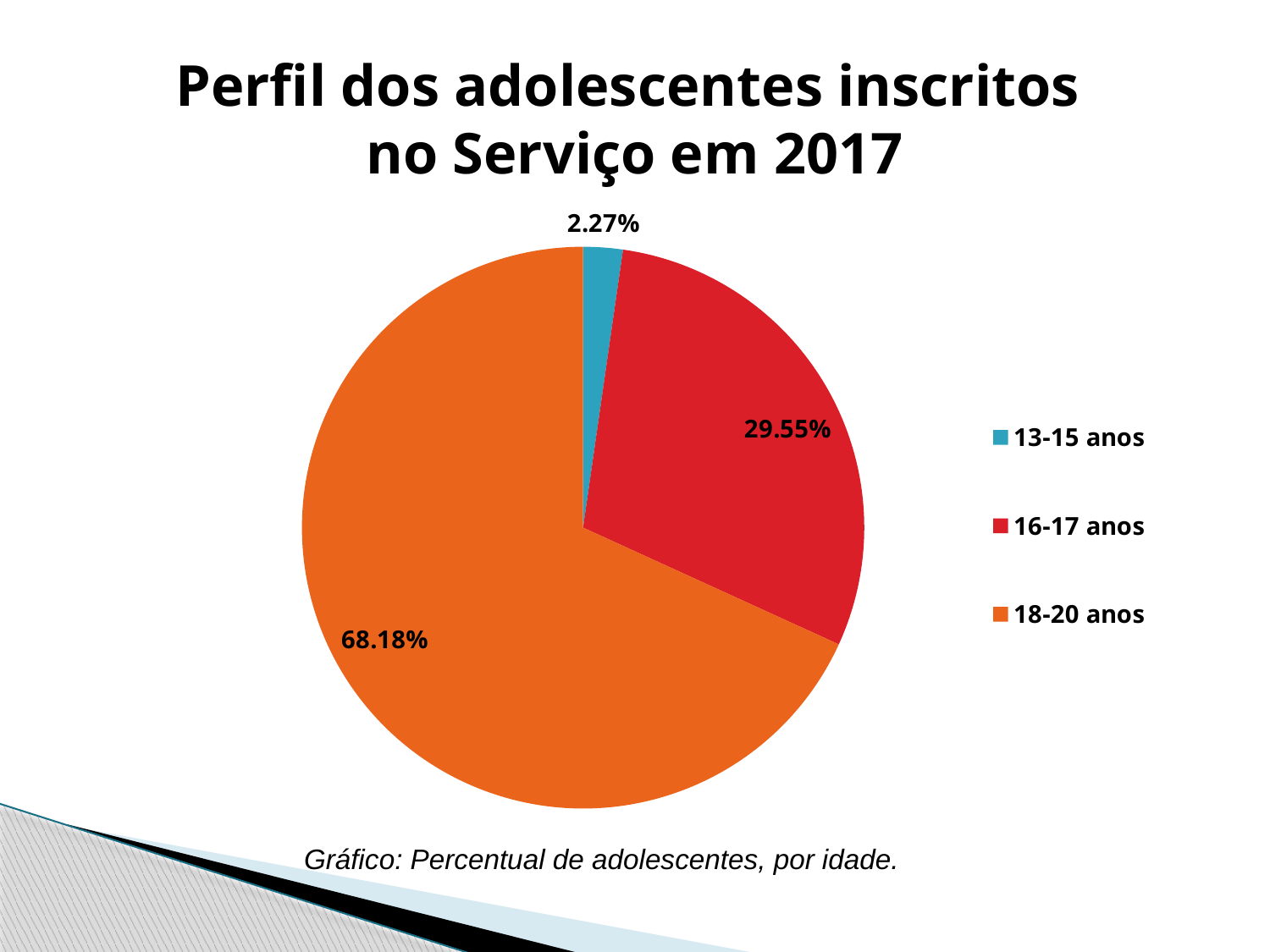
What percentage of adolescents are in the 18-20 anos group? 68.18% How many age groups are shown in the pie chart? 3 Which age group has the smallest share of the pie? 13-15 anos Which group has a larger share: 16-17 anos or 13-15 anos? 16-17 anos What is the combined share of the 13-15 anos and 16-17 anos groups? 31.82% What is the title of the slide containing the chart? Perfil dos adolescentes inscritos no Serviço em 2017 What type of chart is shown on the slide? pie chart Which age group has the largest share of the pie? 18-20 anos What percentage of adolescents are in the 13-15 anos group? 2.27% What percentage of adolescents are in the 16-17 anos group? 29.55% What is the difference in percentage points between the 18-20 anos and 16-17 anos groups? 38.63 What colour represents the 16-17 anos group in the chart? red